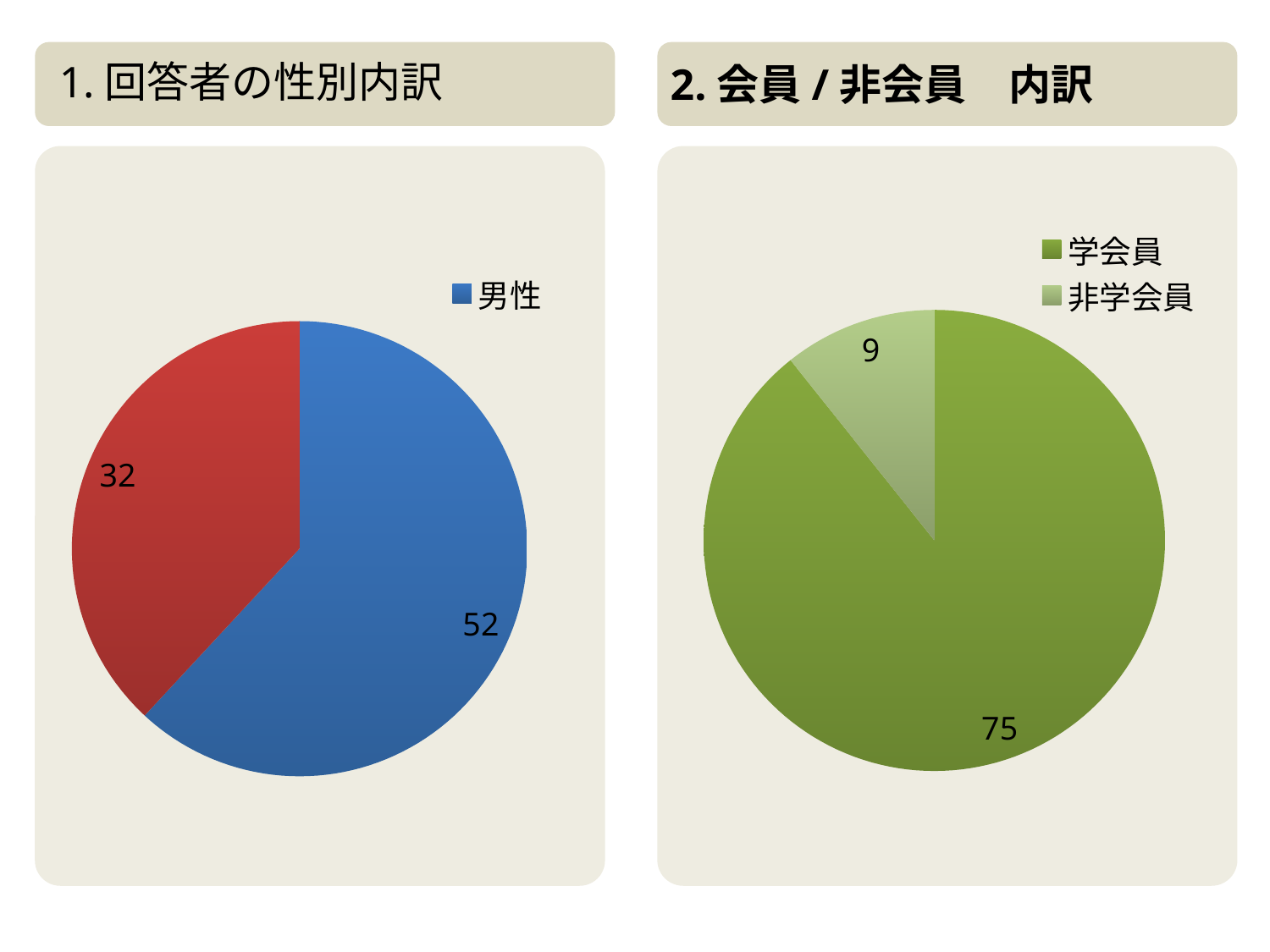
How many entries does the legend of the chart "2. 会員 / 非会員 内訳" list? 2 In the chart "2. 会員 / 非会員 内訳", what is the value for 学会員? 75 How many slices does the pie chart "1. 回答者の性別内訳" have? 2 In the chart "1. 回答者の性別内訳", what is the difference between the larger slice and the smaller slice? 20 What kind of chart is shown under "1. 回答者の性別内訳"? pie chart In the chart "2. 会員 / 非会員 内訳", which category has the largest slice? 学会員 In the chart "2. 会員 / 非会員 内訳", what is the difference between 学会員 and 非学会員? 66 How many entries does the legend of the chart "1. 回答者の性別内訳" list? 1 In the chart "2. 会員 / 非会員 内訳", which category has the smallest slice? 非学会員 In the chart "1. 回答者の性別内訳", what is the value for 男性? 52 What kind of chart is shown under "2. 会員 / 非会員 内訳"? pie chart In the chart "2. 会員 / 非会員 内訳", what is the value for 非学会員? 9